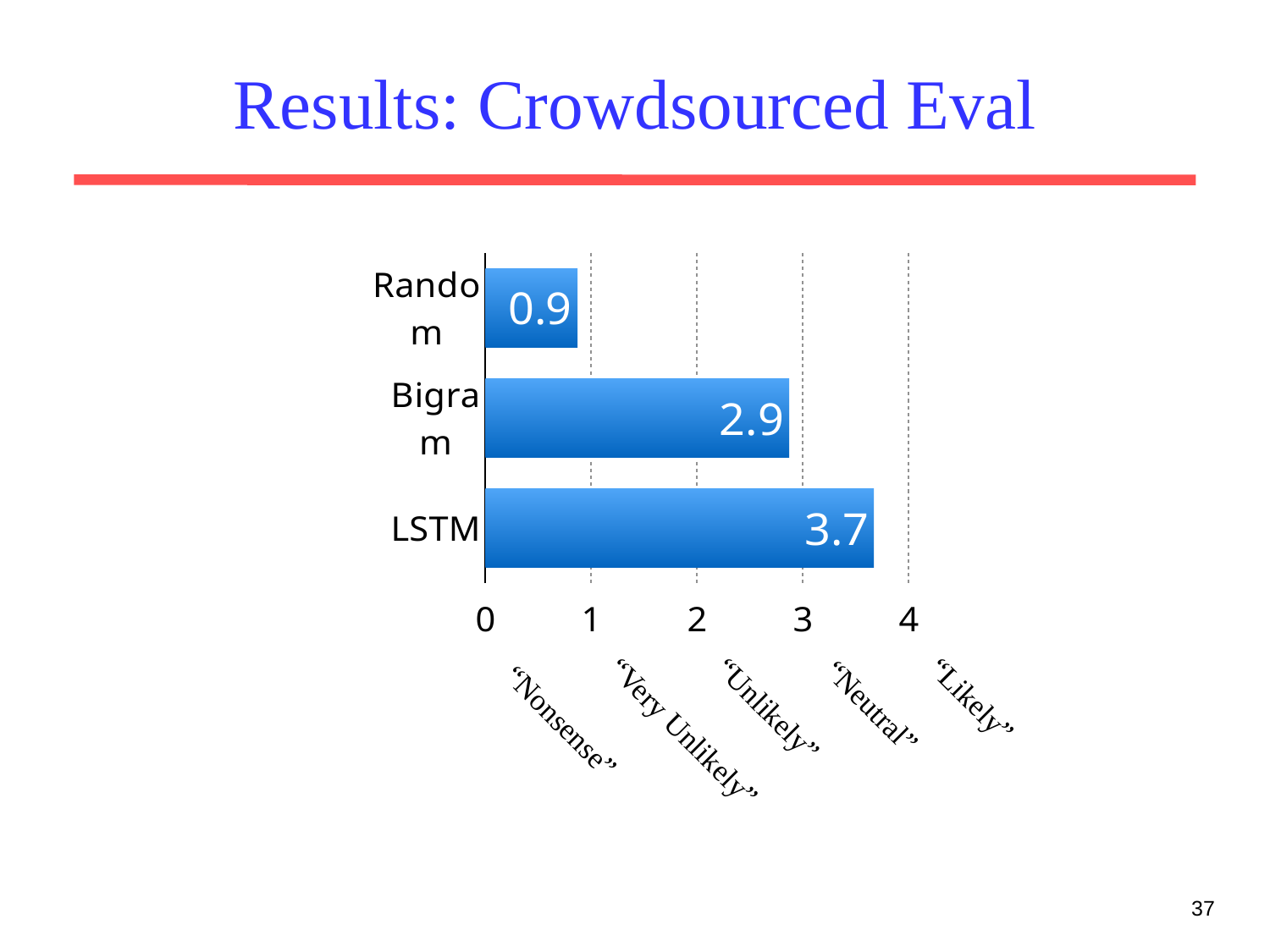
Which is larger, the value for Bigram or the value for Random? Bigram Which category has the lowest value? Random What is the value for Random? 0.9 What is the difference between the values for LSTM and Bigram? 0.8 What kind of chart is shown on the slide? bar chart What is the value for Bigram? 2.9 What is the value for LSTM? 3.7 Is the value for LSTM greater or less than 3? greater What label on the axis corresponds to the value 4? "Likely" Which category has the highest value? LSTM How many categories are shown in the chart? 3 What is the difference between the values for Bigram and Random? 2